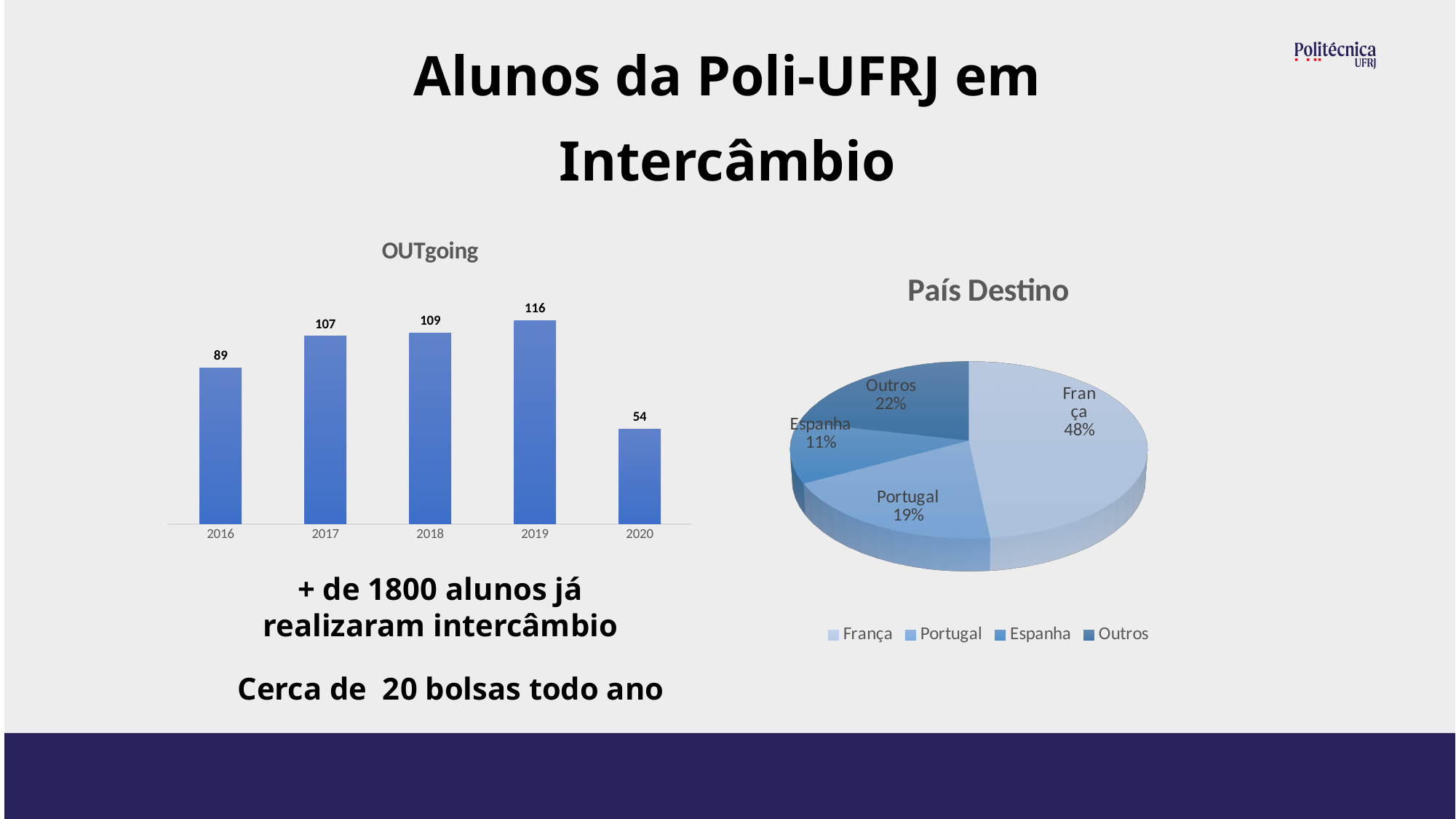
In the OUTgoing chart, which year has the highest value? 2019 What kind of chart is the OUTgoing chart? bar chart In the OUTgoing chart, what is the value for 2020? 54 In the OUTgoing chart, how many years are shown on the x axis? 5 In the País Destino chart, which category has the smallest slice? Espanha How many entries does the legend of the País Destino chart list? 4 In the OUTgoing chart, what is the difference between the values for 2019 and 2020? 62 In the OUTgoing chart, what is the value for 2019? 116 In the País Destino chart, what share does França have? 48% In the OUTgoing chart, which is larger, the value for 2016 or the value for 2017? 2017 In the OUTgoing chart, which year has the lowest value? 2020 In the País Destino chart, what share does Espanha have? 11%